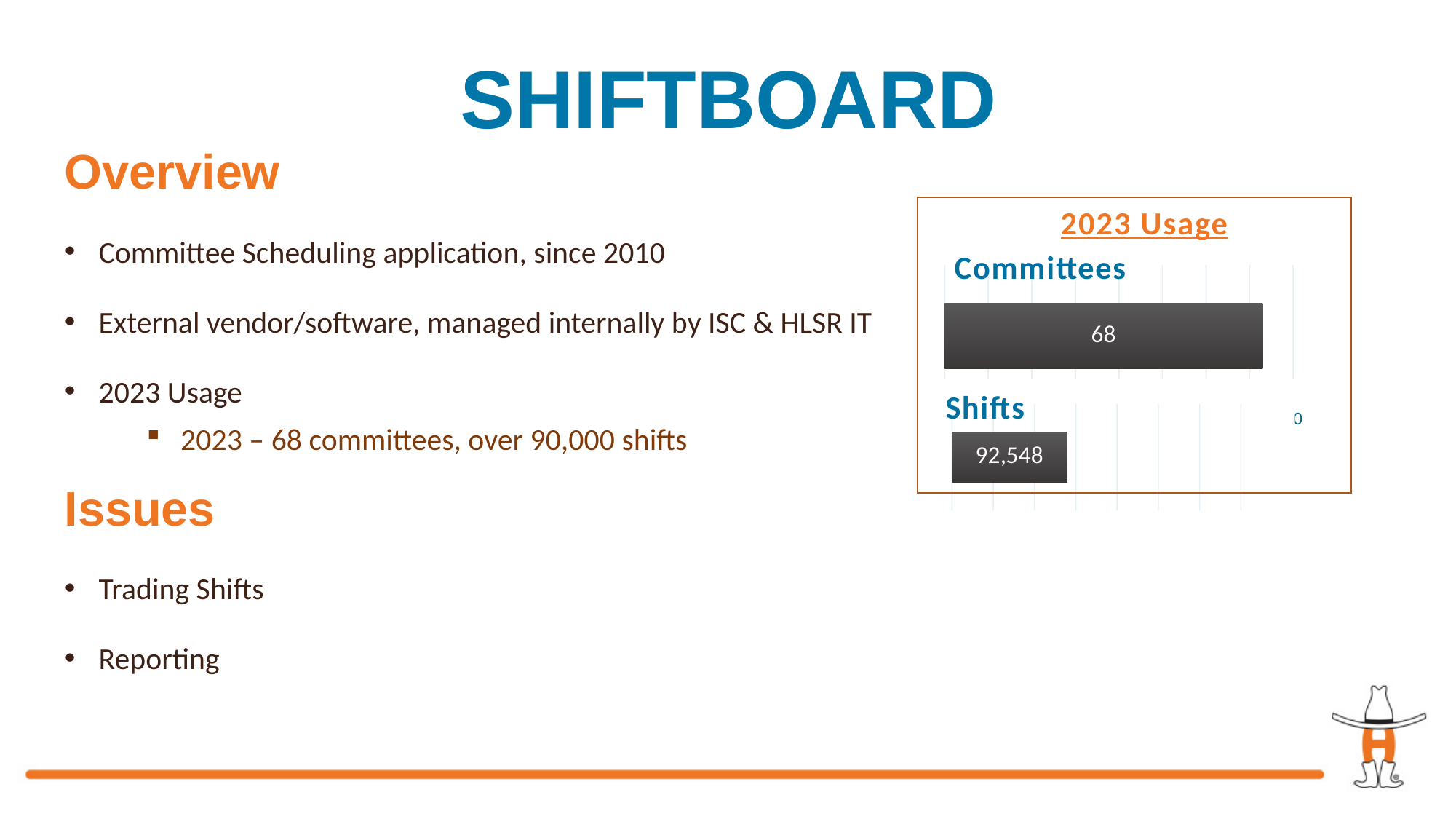
What kind of chart is used to show the 2023 Usage data? Bar chart Which category has the higher value in the 2023 Usage chart, Committees or Shifts? Shifts What is the value shown for Committees in the 2023 Usage chart? 68 What are the two category labels in the 2023 Usage chart? Committees and Shifts How many categories are shown in the 2023 Usage chart? 2 What is the difference between the Shifts value and the Committees value in the 2023 Usage chart? 92,480 Which category has the lowest value in the 2023 Usage chart? Committees What is the value shown for Shifts in the 2023 Usage chart? 92,548 What is the title of the chart on the slide? 2023 Usage